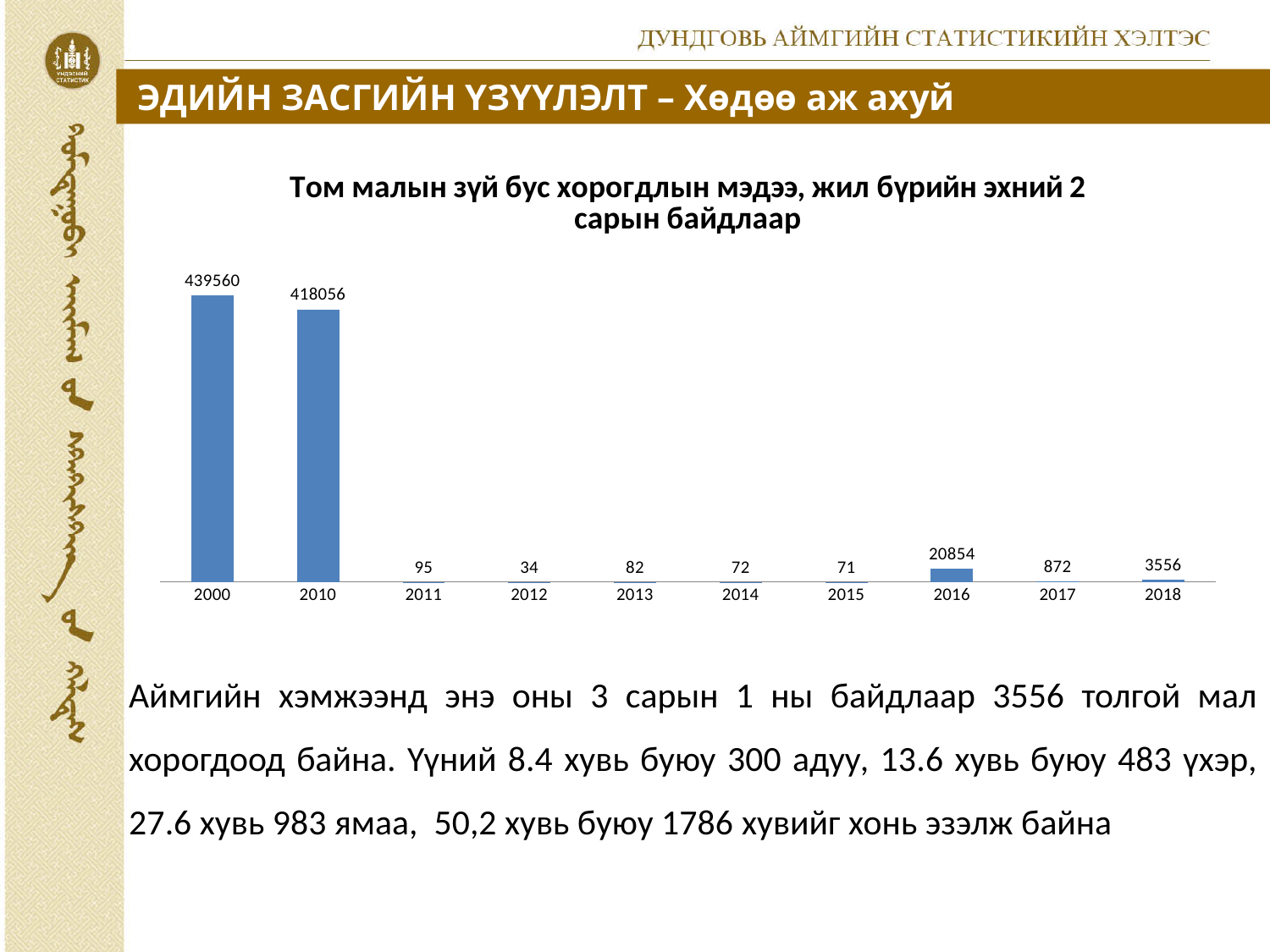
What is the title of the chart? Том малын зүй бус хорогдлын мэдээ, жил бүрийн эхний 2 сарын байдлаар What is the difference between the values for 2000 and 2010? 21504 Which year has the highest value? 2000 How many years are shown on the x axis? 10 What is the value for 2018? 3556 What type of chart is shown on the slide? bar chart What is the value for 2000? 439560 Which year has the lowest value? 2012 What is the difference between the values for 2018 and 2017? 2684 What is the value for 2012? 34 Which is larger, the value for 2013 or the value for 2014? 2013 What is the value for 2016? 20854